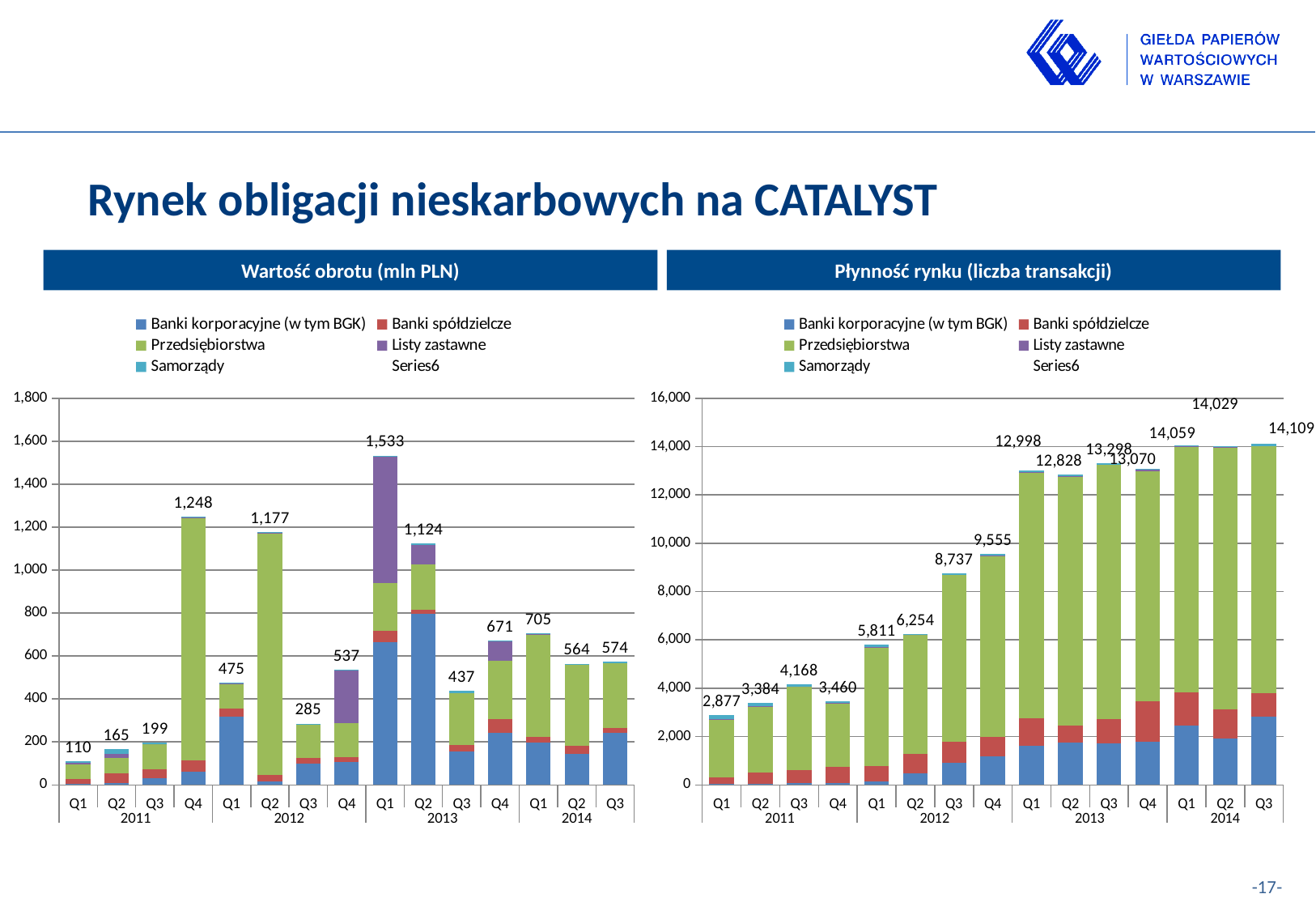
In the 'Wartość obrotu (mln PLN)' chart, how many quarters are plotted on the x axis? 15 In the 'Płynność rynku (liczba transakcji)' chart, what is the total for Q1 2011? 2,877 In the 'Wartość obrotu (mln PLN)' chart, what is the total value for Q1 2013? 1,533 In the 'Płynność rynku (liczba transakcji)' chart, what is the difference between the totals for Q1 2013 and Q4 2012? 3,443 In the 'Wartość obrotu (mln PLN)' chart, what is the difference between the totals for Q4 2011 and Q1 2012? 773 In the 'Płynność rynku (liczba transakcji)' chart, what is the total for Q3 2014? 14,109 In the 'Wartość obrotu (mln PLN)' chart, which quarter has the lowest total? Q1 2011 In the 'Płynność rynku (liczba transakcji)' chart, is the total for Q3 2012 greater or less than 8,000? greater What kind of chart is the 'Płynność rynku (liczba transakcji)' chart? Stacked bar chart In the 'Wartość obrotu (mln PLN)' chart, which quarter has the highest total? Q1 2013 How many series does the legend of the 'Wartość obrotu (mln PLN)' chart list? 6 In the 'Płynność rynku (liczba transakcji)' chart, which is larger, the total for Q4 2012 or Q3 2012? Q4 2012